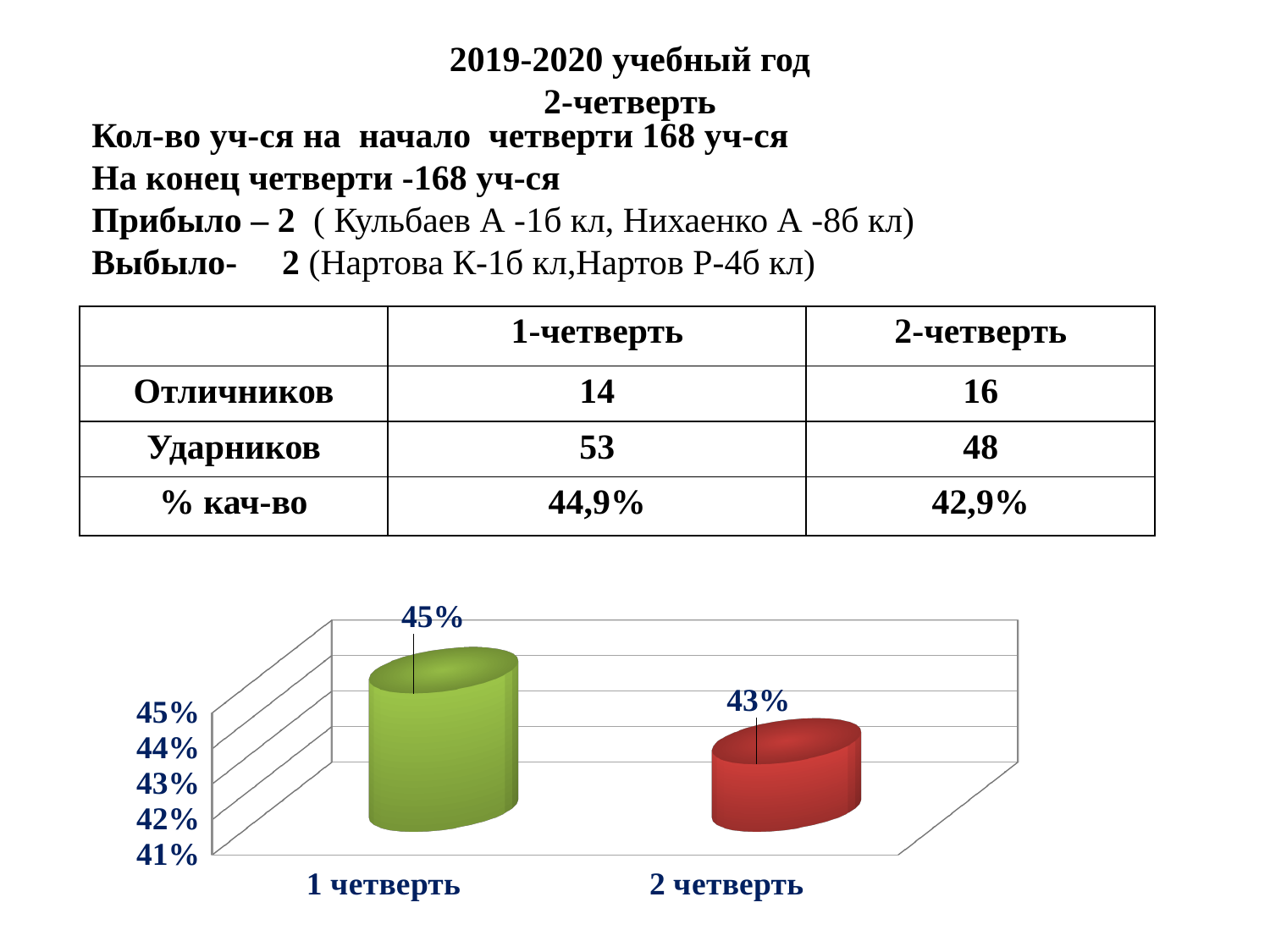
Is the value for 2 четверть greater or less than 44%? less What colour is the bar for 2 четверть in the chart? red Which category has the lowest value in the chart? 2 четверть How many categories are plotted in the chart? 2 What is the value shown for 1 четверть in the chart? 45% What is the difference between the values for 1 четверть and 2 четверть in the chart? 2% What is the value shown for 2 четверть in the chart? 43% What kind of chart is shown on the slide? bar chart Is the value for 1 четверть greater or less than 44%? greater Which is larger in the chart, the value for 1 четверть or for 2 четверть? 1 четверть Which category has the highest value in the chart? 1 четверть Do the values rise or fall from 1 четверть to 2 четверть in the chart? fall